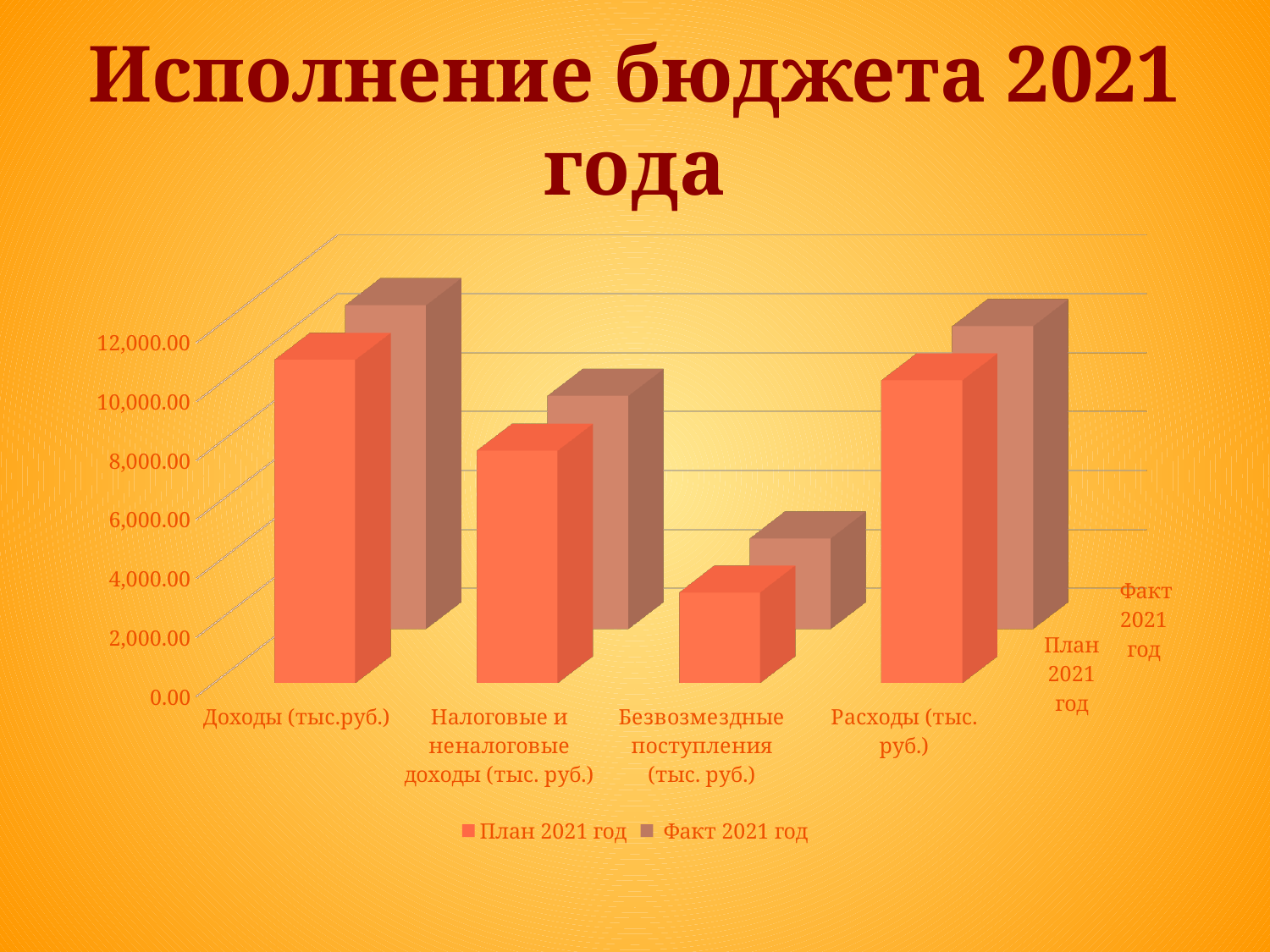
How many series does the legend list? 2 Which category has the lowest value for Факт 2021 год? Безвозмездные поступления (тыс. руб.) Which is larger for План 2021 год: Доходы (тыс.руб.) or Безвозмездные поступления (тыс. руб.)? Доходы (тыс.руб.) Which is larger for План 2021 год: Расходы (тыс. руб.) or Налоговые и неналоговые доходы (тыс. руб.)? Расходы (тыс. руб.) How many categories are shown on the x axis? 4 Is the value for План 2021 год for Доходы (тыс.руб.) greater or less than 8,000.00? greater Which series is shown in the darker brown colour? Факт 2021 год Is the value for План 2021 год for Безвозмездные поступления (тыс. руб.) greater or less than 6,000.00? less Is the value for План 2021 год for Налоговые и неналоговые доходы (тыс. руб.) greater or less than 6,000.00? greater What is the title of the chart on the slide? Исполнение бюджета 2021 года What kind of chart is shown on the slide? bar chart Which category has the lowest value for План 2021 год? Безвозмездные поступления (тыс. руб.)